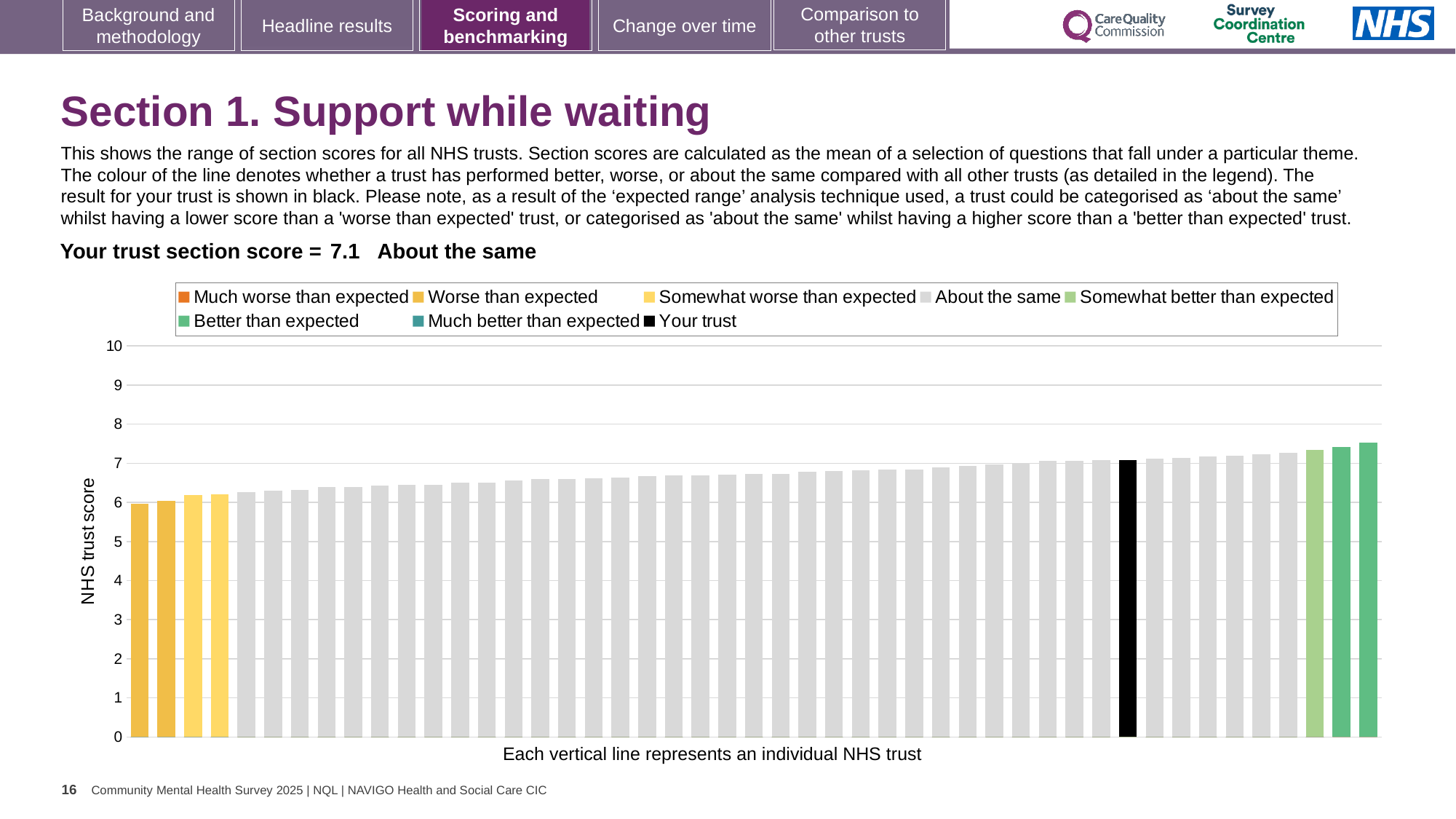
What kind of chart is shown on the slide? bar chart How many bars are coloured as 'Better than expected' (green) in the chart? 2 Which is larger: the black bar for your trust or the leftmost bar in the chart? the black bar (your trust) Is the value of the lowest bar in the chart greater or less than 5? greater Is the value of the black bar (your trust) greater or less than 5? greater According to the legend, what colour represents 'Your trust'? black Is the value of the highest bar in the chart greater or less than 8? less What is the label on the vertical axis of the chart? NHS trust score What is the section score for your trust shown on the slide? 7.1 Do the bar values rise or fall from left to right along the x axis? rise Which performance category is your trust placed in for this section? About the same How many entries does the chart legend list? 8